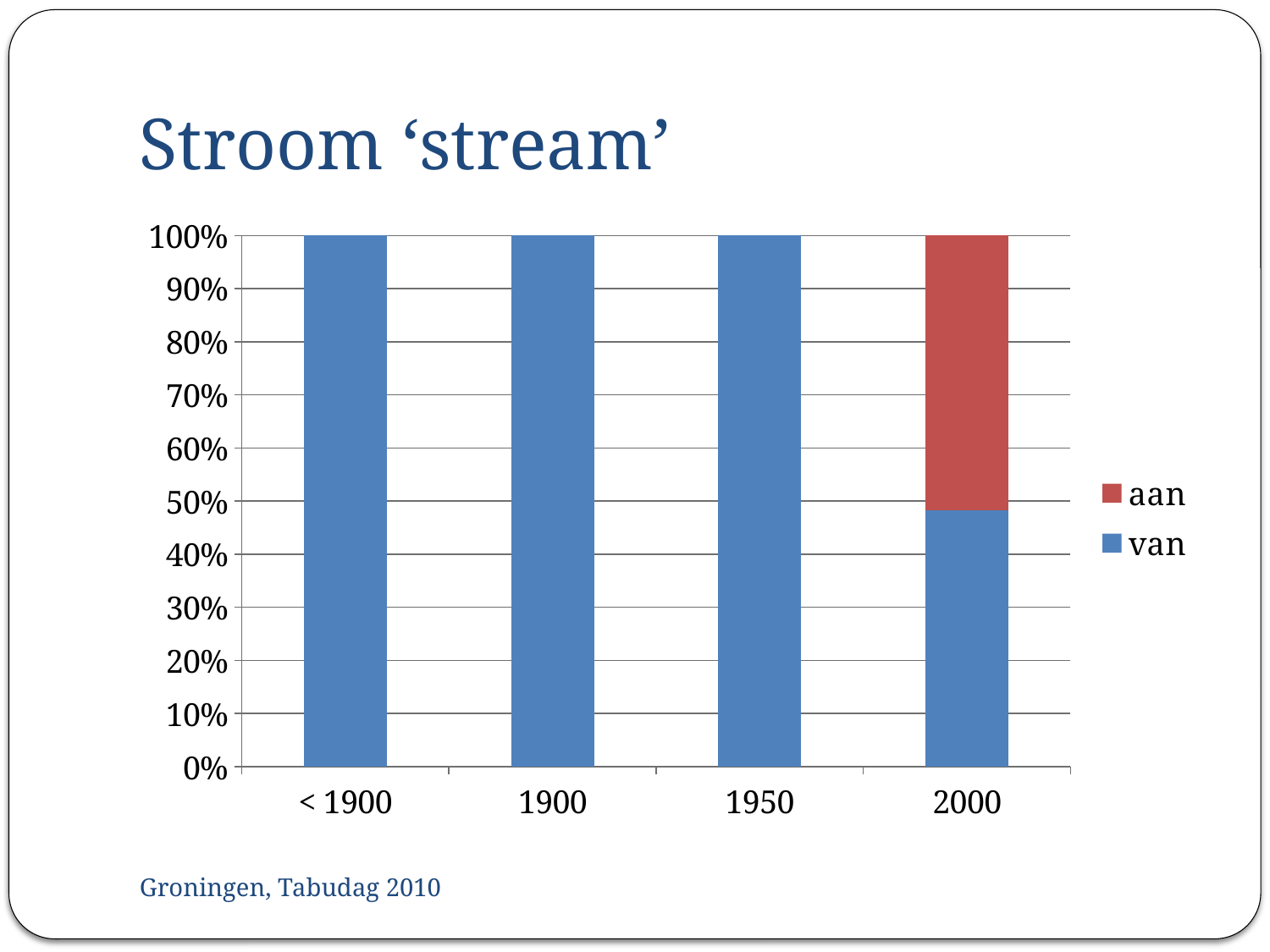
Is the value of 'van' for 2000 greater or less than 60%? less How many categories are shown on the x axis? 4 How many series does the legend list? 2 What is the title of the chart? Stroom ‘stream’ Which is larger: the value of 'van' for 1950 or for 2000? 1950 What kind of chart is shown on the slide? bar chart Is the value of 'aan' for 2000 greater or less than 40%? greater Which series are listed in the legend? aan, van What is the value of 'van' for the category 1900? 100% Which category has the highest value for 'aan'? 2000 Which category has the lowest value for 'van'? 2000 What is the value of 'van' for the category < 1900? 100%